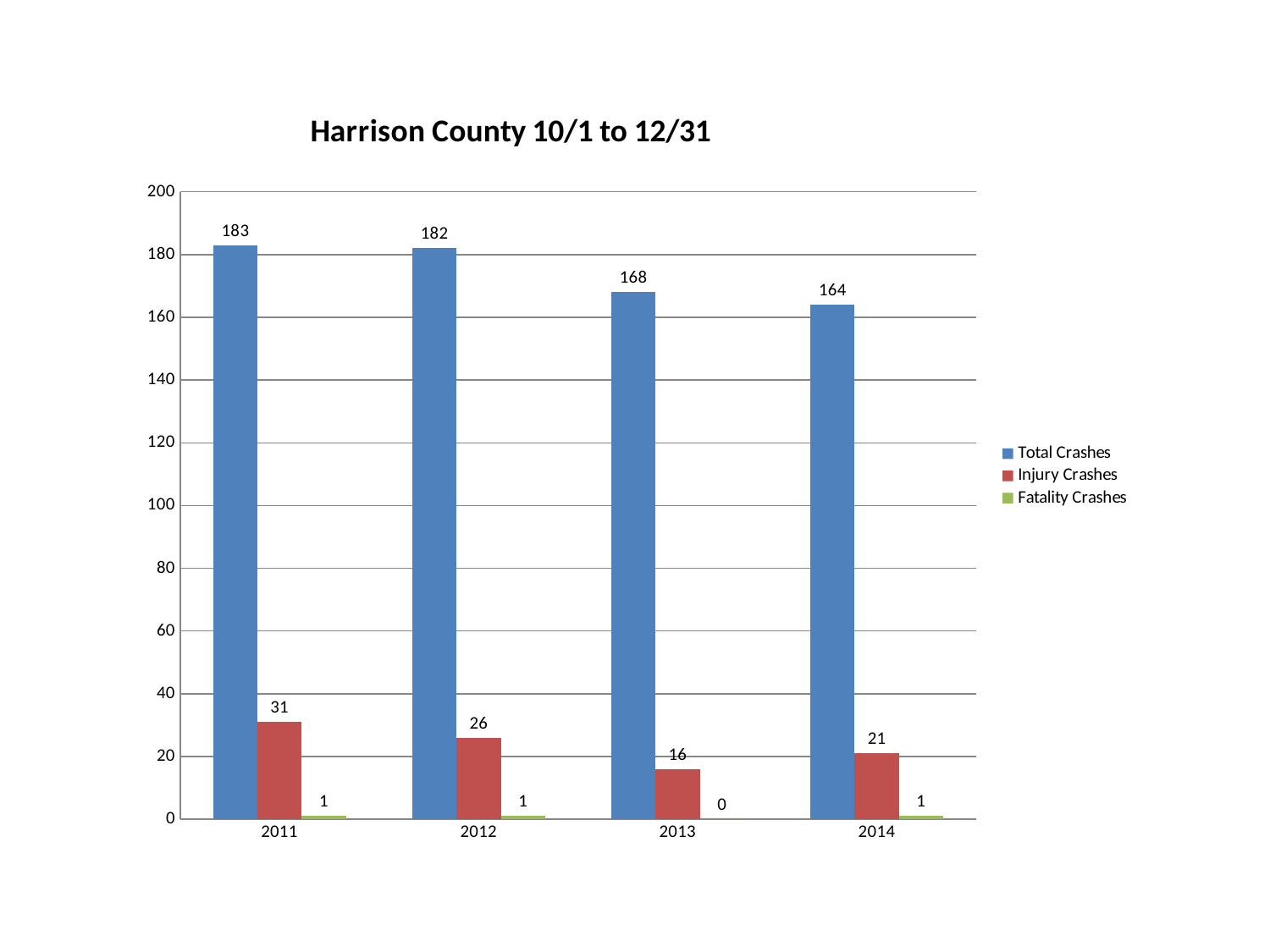
What kind of chart is shown on the slide? bar chart What is the value for Injury Crashes in 2012? 26 Which year has the highest value for Total Crashes? 2011 Is the value for Total Crashes in 2014 greater or less than 180? less What is the difference between Total Crashes in 2011 and Total Crashes in 2014? 19 Which year has the lowest value for Injury Crashes? 2013 What is the value for Total Crashes in 2013? 168 How many series does the legend list? 3 What is the value for Fatality Crashes in 2013? 0 What is the title of the chart? Harrison County 10/1 to 12/31 How many years are shown on the x axis? 4 Which is larger: Injury Crashes in 2012 or Injury Crashes in 2014? Injury Crashes in 2012